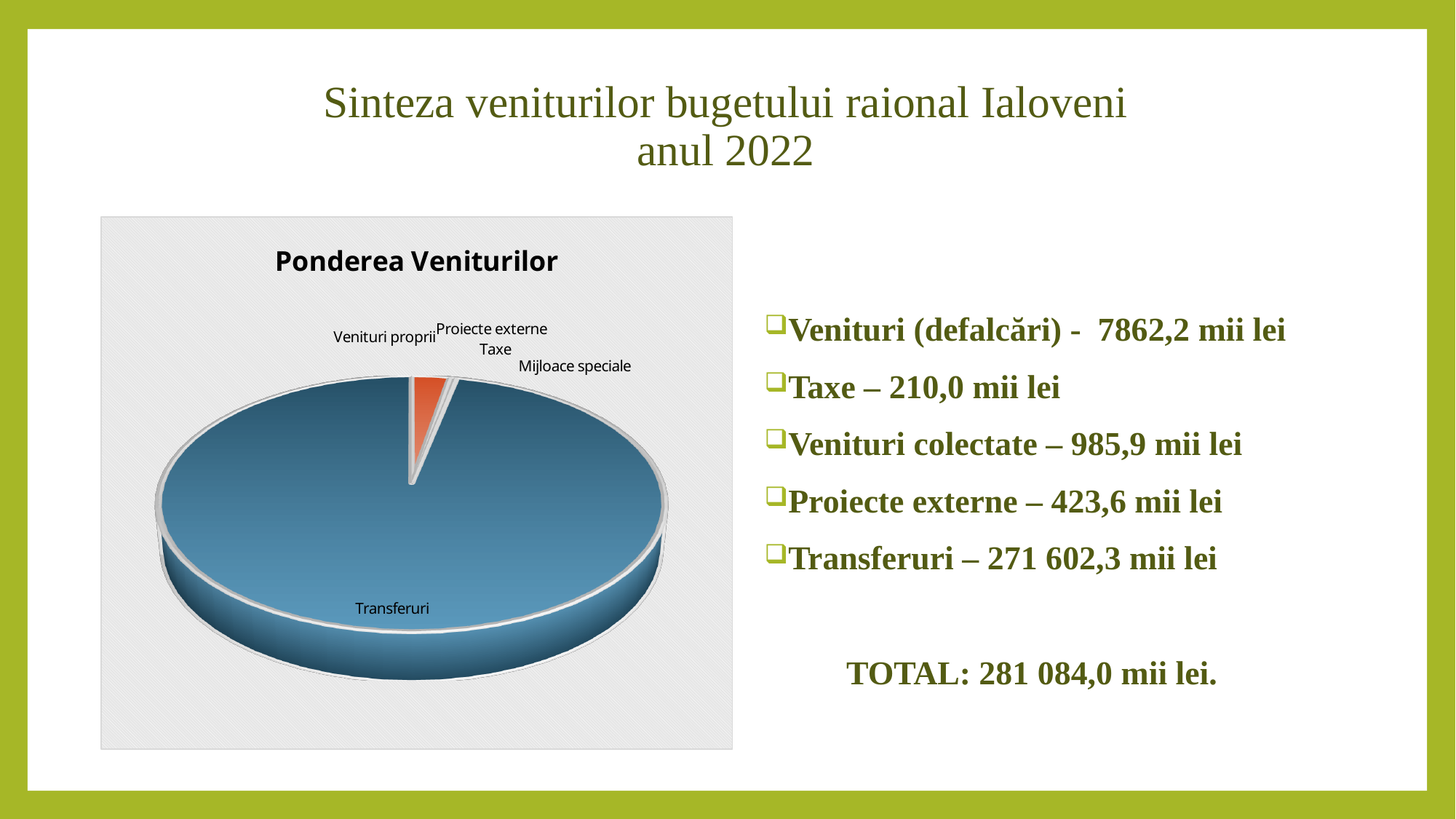
Which slice is larger, Transferuri or Venituri proprii? Transferuri How many categories are labelled on the pie chart? 5 Which category is shown in orange on the pie chart? Venituri proprii Which slice is larger, Venituri proprii or Taxe? Venituri proprii What colour is the largest slice of the pie chart? Blue Which category has the largest slice of the pie chart? Transferuri Does the Venituri proprii slice take up more or less than half of the pie? less Does the Transferuri slice take up more or less than half of the pie? more What kind of chart is shown on the slide? Pie chart What is the title of the chart? Ponderea Veniturilor